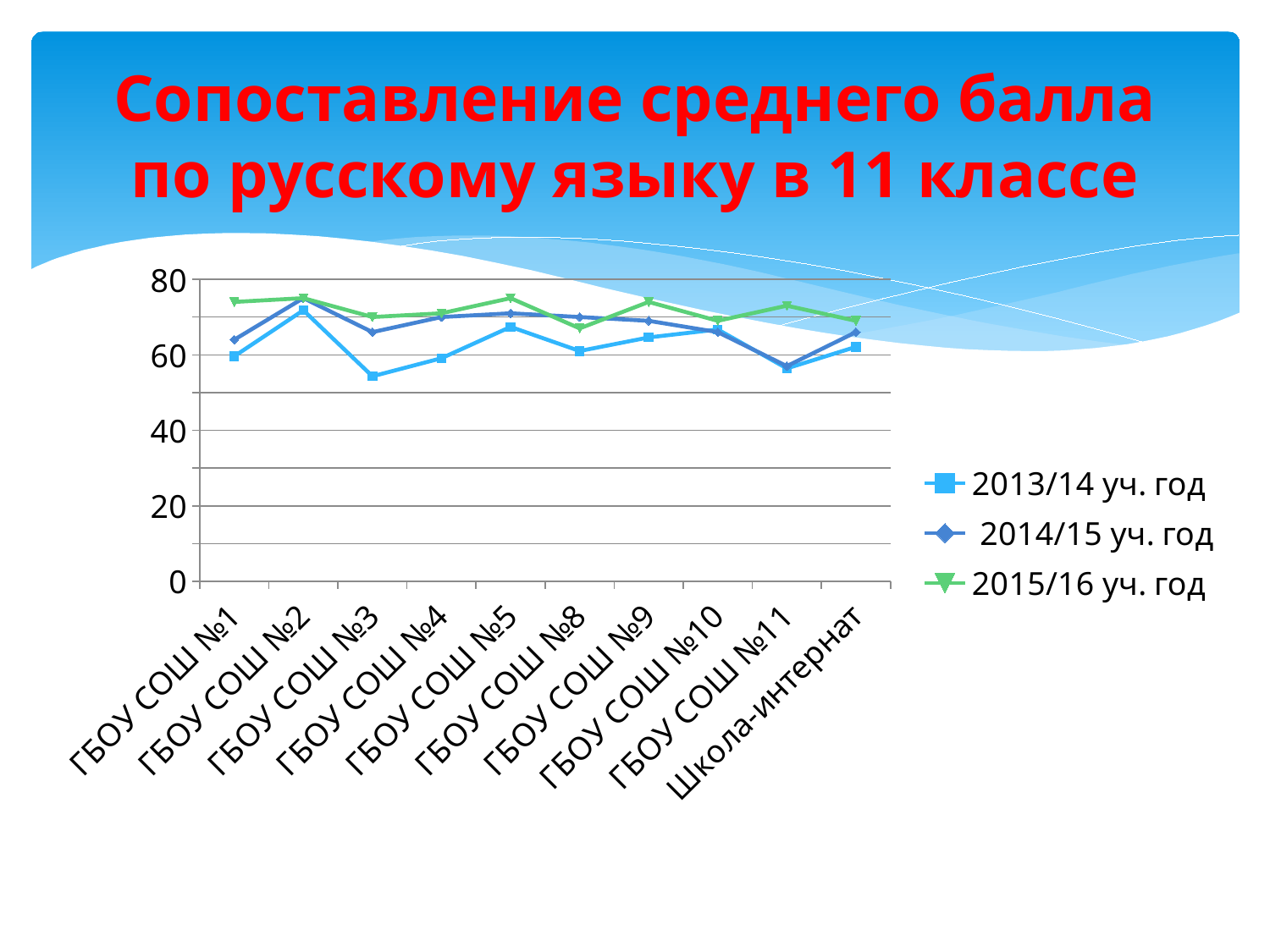
What is the title of the slide? Сопоставление среднего балла по русскому языку в 11 классе Is the 2013/14 уч. год value for ГБОУ СОШ №3 greater or less than 60? less For the 2014/15 уч. год series, which school has the lowest value? ГБОУ СОШ №11 Is the 2014/15 уч. год value for ГБОУ СОШ №11 greater or less than 60? less For the 2014/15 уч. год series, which school has the highest value? ГБОУ СОШ №2 Which series is drawn in green? 2015/16 уч. год Which series has the lowest value for ГБОУ СОШ №3? 2013/14 уч. год What kind of chart is shown on the slide? line chart In the 2013/14 уч. год series, which is larger: the value for ГБОУ СОШ №2 or for ГБОУ СОШ №3? ГБОУ СОШ №2 How many schools (categories) are plotted along the x axis? 10 How many series does the legend list? 3 Is the 2015/16 уч. год value for ГБОУ СОШ №1 greater or less than 70? greater